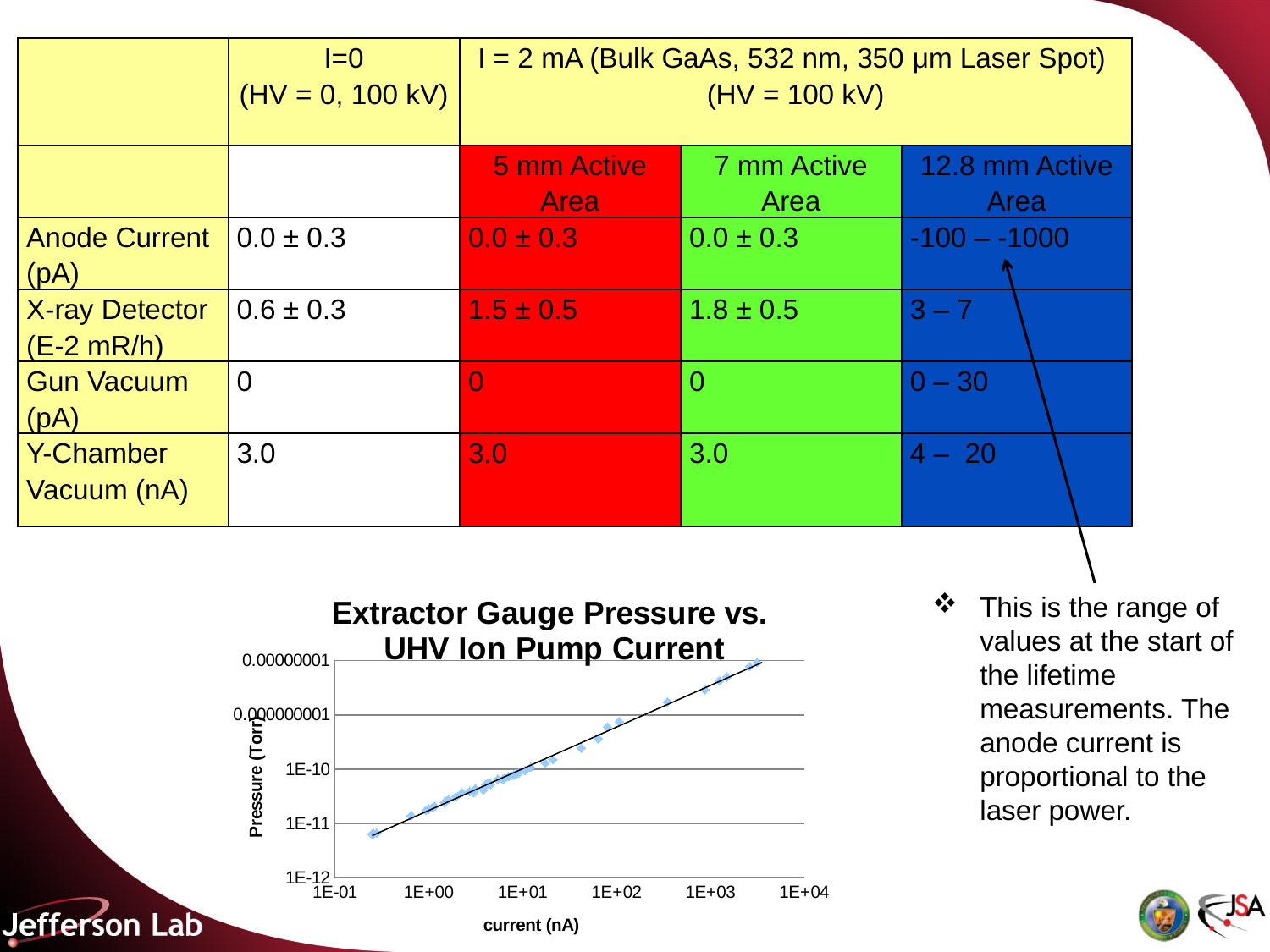
Is the pressure for the highest-current points (near 1E+04 nA) greater or less than 1E-09 Torr? greater Does the pressure rise or fall as the current increases along the x axis? rise What is the label of the x axis of the chart? current (nA) Is the pressure for points at a current of about 1E+00 nA greater or less than 1E-10 Torr? less What is the lowest value shown on the y axis of the chart? 1E-12 What kind of chart is shown on the slide? scatter chart Is the pressure for points at a current of about 1E+02 nA greater or less than 1E-10 Torr? greater What is the title of the chart on the slide? Extractor Gauge Pressure vs. UHV Ion Pump Current